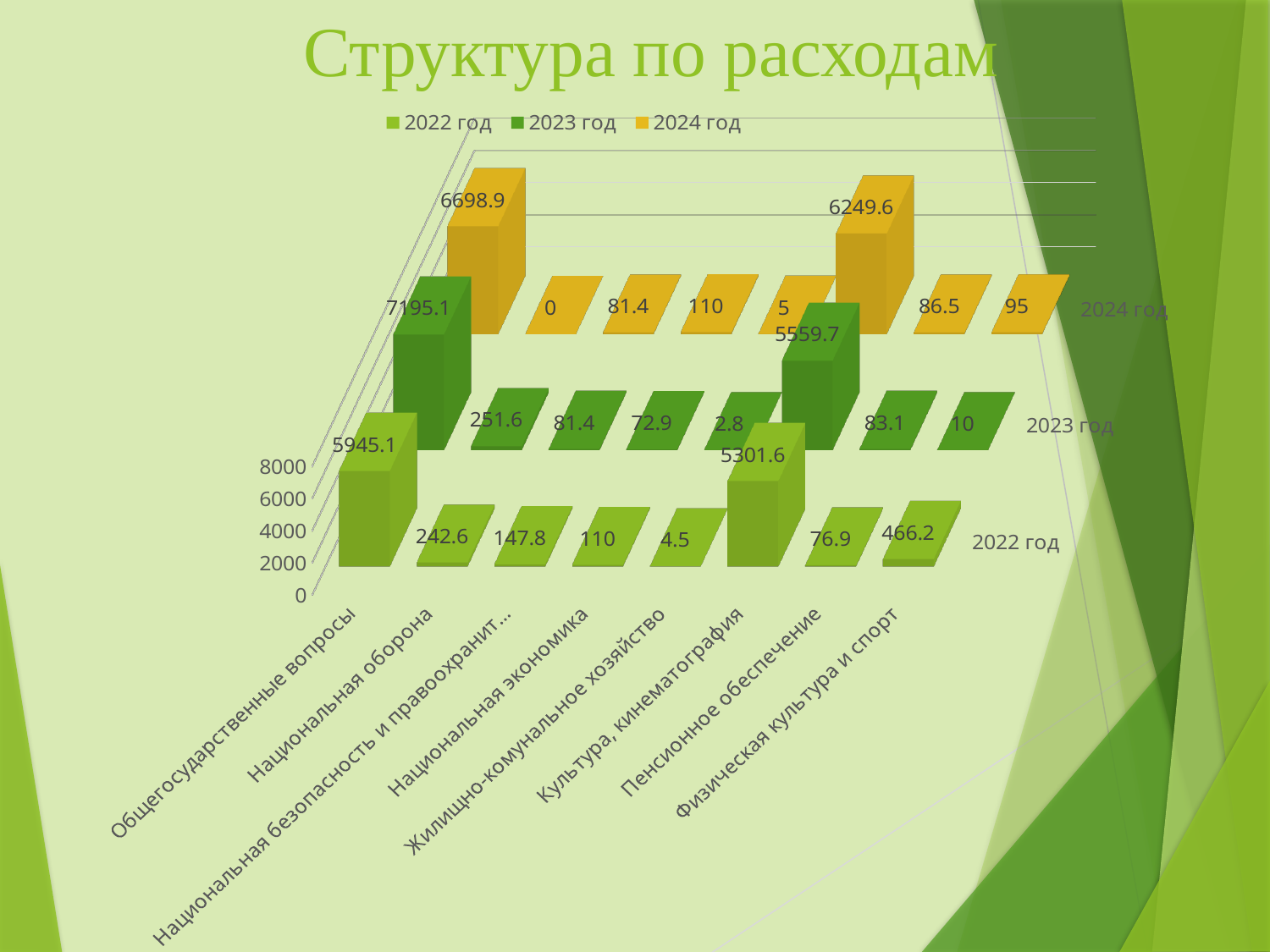
What is the value for Жилищно-коммунальное хозяйство in the 2023 год series? 2.8 What is the difference between the 2023 год and 2022 год values for Общегосударственные вопросы? 1250 What is the value for Культура, кинематография in the 2024 год series? 6249.6 Which category has the highest value in the 2023 год series? Общегосударственные вопросы What is the value for Общегосударственные вопросы in the 2022 год series? 5945.1 What kind of chart is shown on the slide? bar chart How many series does the legend list? 3 What is the value for Пенсионное обеспечение in the 2024 год series? 86.5 Which category has the lowest value in the 2024 год series? Национальная оборона How many categories are shown on the x axis? 8 What is the title of the chart? Структура по расходам Which is larger for Физическая культура и спорт: the 2022 год value or the 2023 год value? 2022 год